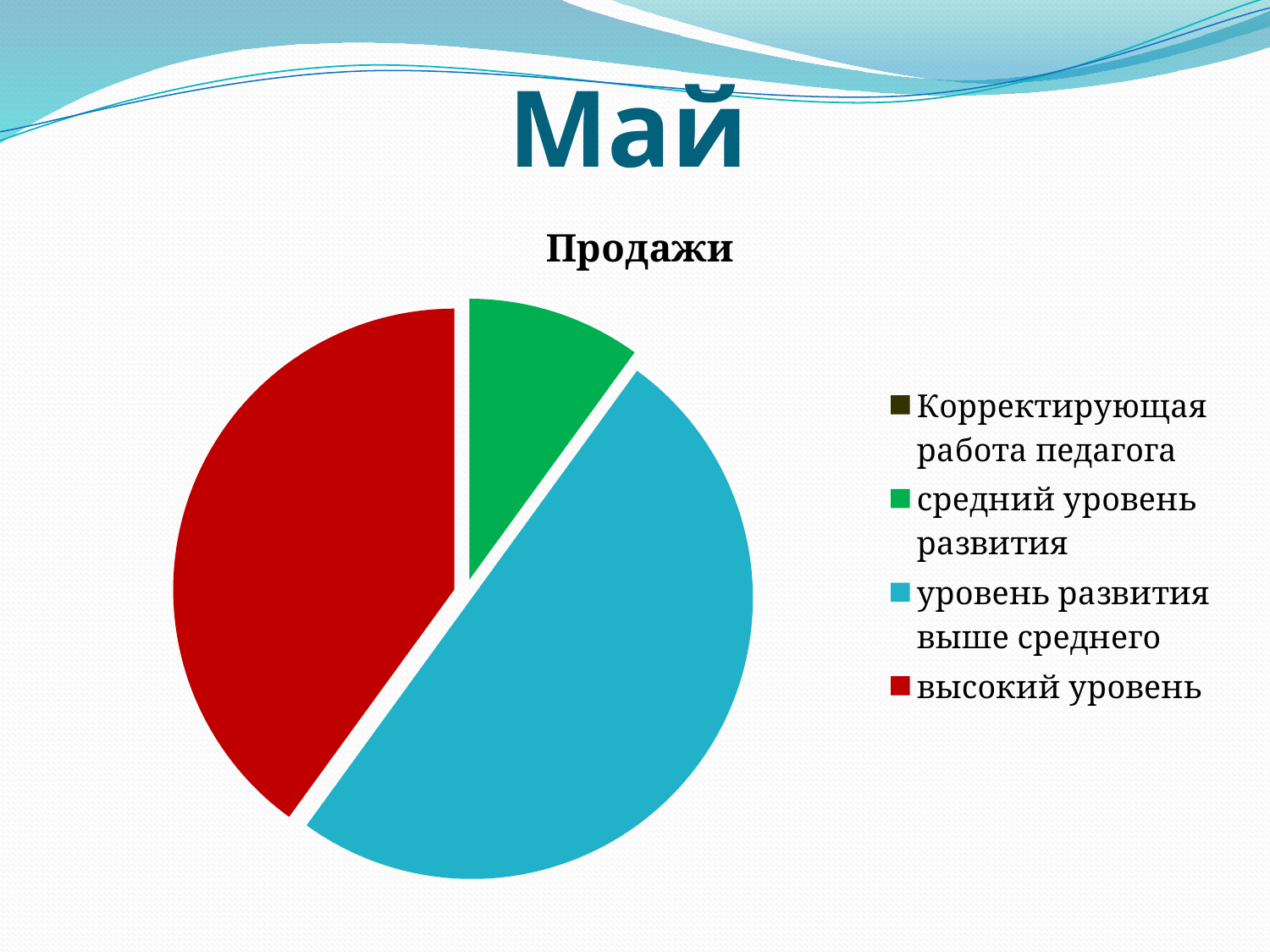
Which category has the largest slice of the pie? уровень развития выше среднего What colour is the slice for высокий уровень? red Which of the visible slices is the smallest? средний уровень развития How many entries does the chart legend list? 4 Which slice is larger: уровень развития выше среднего or высокий уровень? уровень развития выше среднего What is the title of the chart? Продажи Which slice is larger: уровень развития выше среднего or средний уровень развития? уровень развития выше среднего Which slice is larger: высокий уровень or средний уровень развития? высокий уровень What kind of chart is shown on the slide? pie chart How many slices are visible in the pie? 3